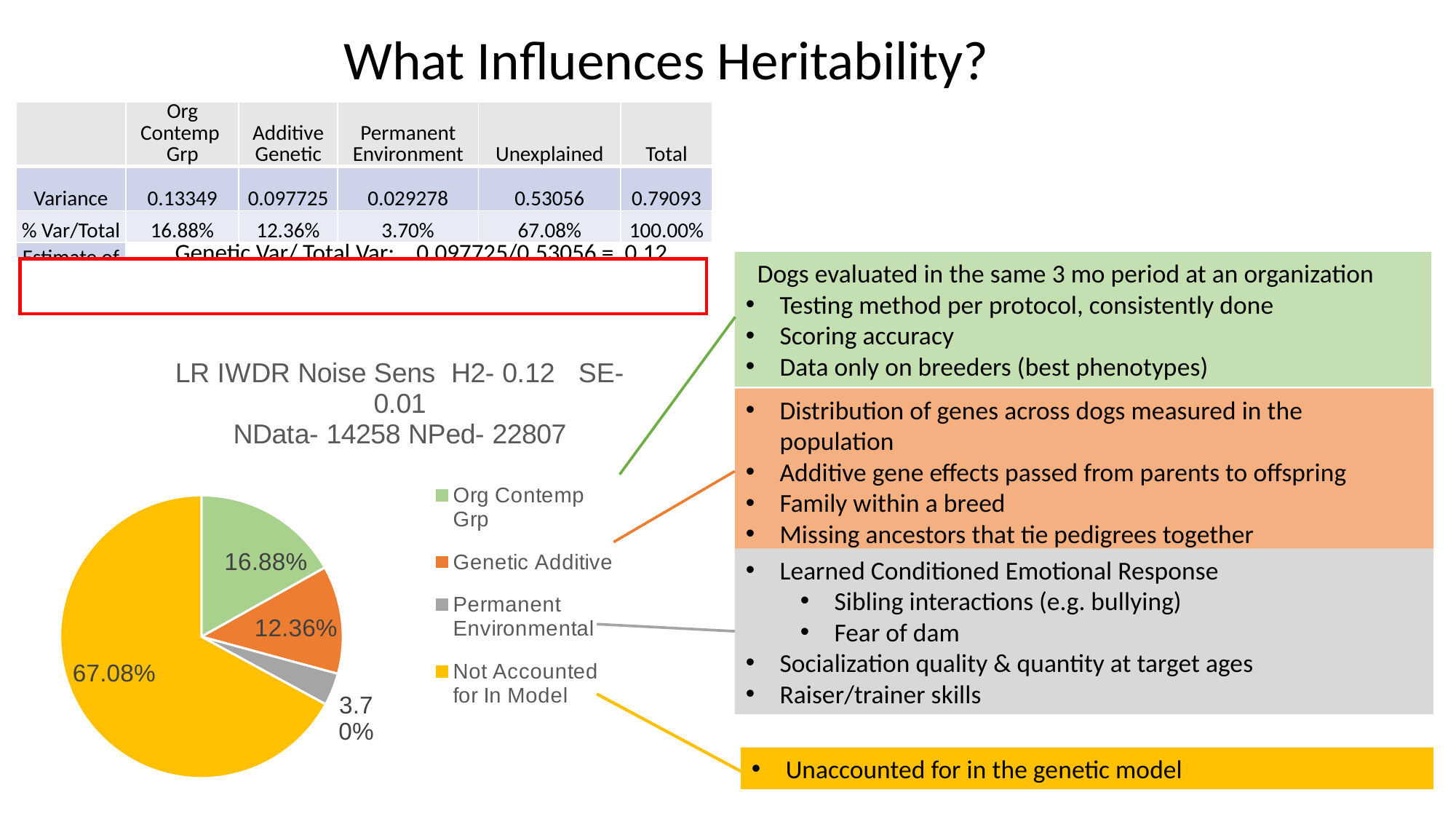
Which is larger in the pie chart, Org Contemp Grp or Genetic Additive? Org Contemp Grp How many entries does the pie chart legend list? 4 What share of the pie does the Permanent Environmental slice represent? 3.70% What kind of chart is shown on the slide? pie chart How many slices does the pie chart have? 4 What share of the pie does the Not Accounted for In Model slice represent? 67.08% Which slice of the pie chart is the largest? Not Accounted for In Model What share of the pie does the Org Contemp Grp slice represent? 16.88% What colour is the Not Accounted for In Model slice in the pie chart? yellow What share of the pie does the Genetic Additive slice represent? 12.36% What is the difference in percentage points between the Org Contemp Grp slice and the Genetic Additive slice? 4.52 Which slice of the pie chart is the smallest? Permanent Environmental